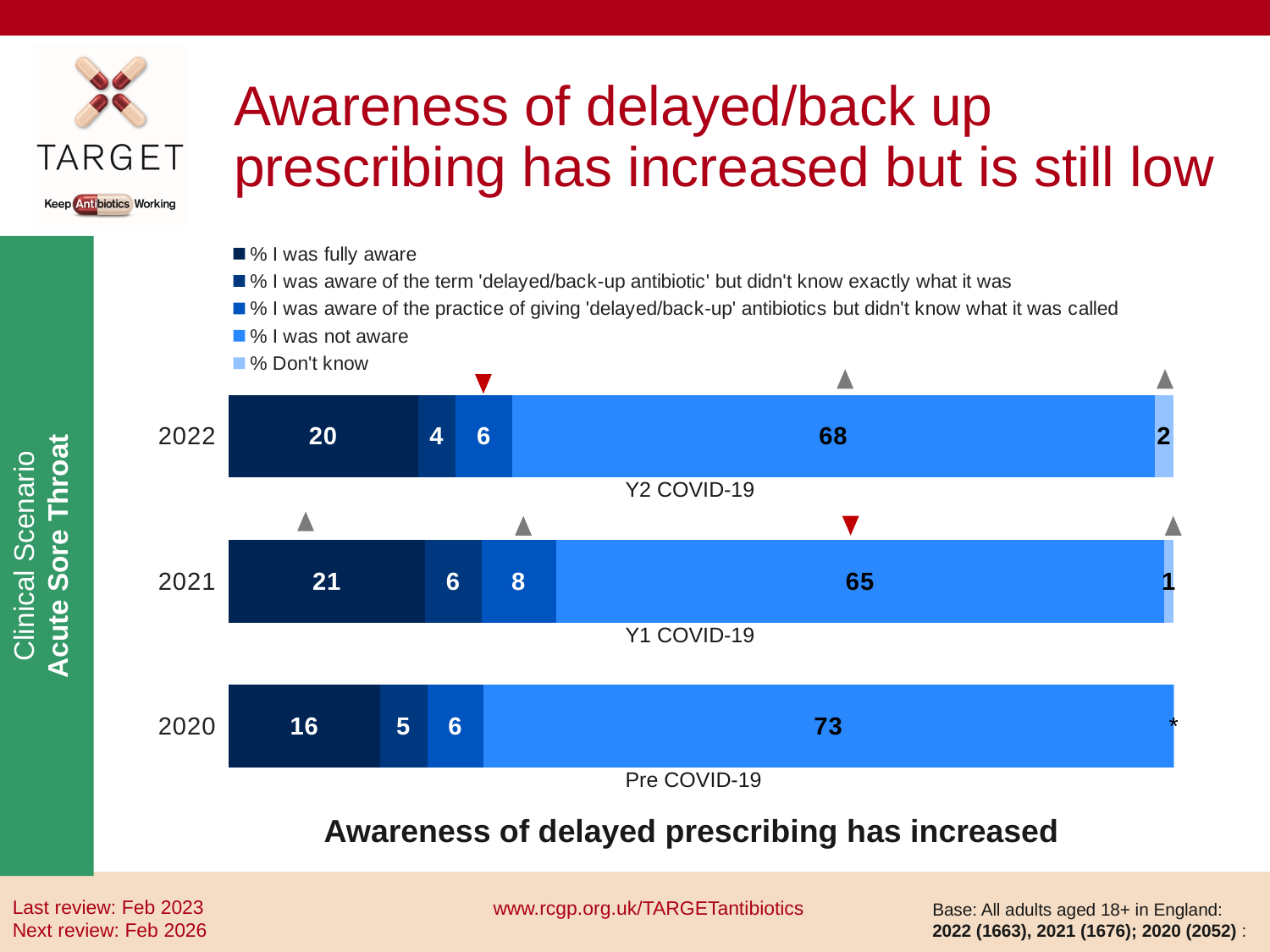
What is the value for '% I was not aware' in 2021? 65 What is the difference between the '% I was not aware' values for 2020 and 2021? 8 What is the value for '% I was aware of the practice of giving 'delayed/back-up' antibiotics but didn't know what it was called' in 2020? 6 Which year has the highest value for '% I was not aware'? 2020 What label appears beneath the 2020 bar? Pre COVID-19 What type of chart is shown on the slide? stacked bar chart Is the '% I was fully aware' value larger in 2021 or in 2022? 2021 What is the value for '% I was fully aware' in 2022? 20 What is the value for '% Don't know' in 2022? 2 How many series does the legend list? 5 Which year has the lowest value for '% I was fully aware'? 2020 How many years (bars) are plotted in the chart? 3